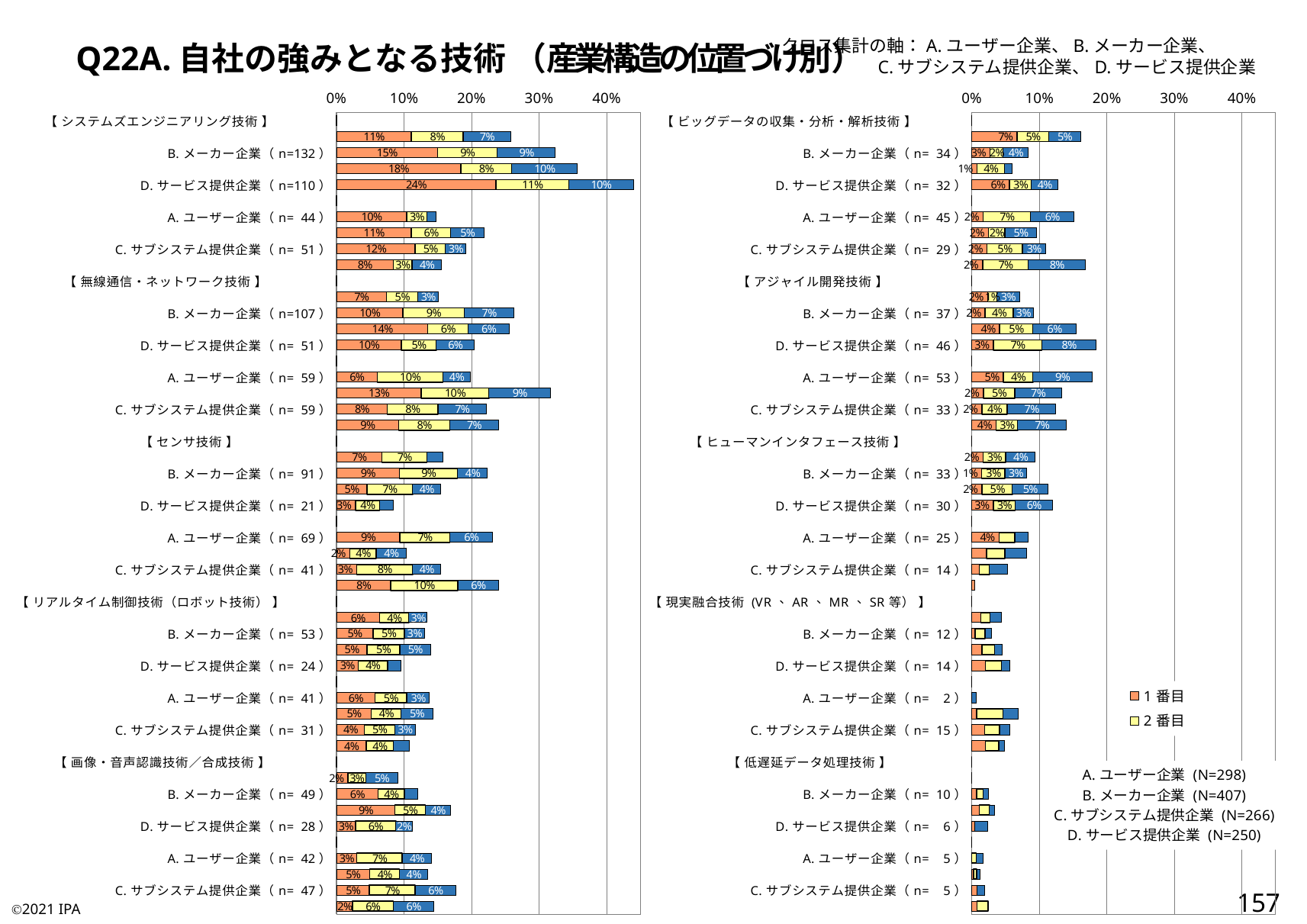
In the right chart, what is the total of the stacked bar for D. サービス提供企業 (n=46) under アジャイル開発技術? 18% In the left chart, what is the 1番目 value for D. サービス提供企業 (n=110) under システムズエンジニアリング技術? 24% In the left chart, is the total bar for D. サービス提供企業 (n=110) under システムズエンジニアリング技術 greater or less than 40%? greater In the left chart, what is the difference between the 1番目 values of D. サービス提供企業 (n=110) and B. メーカー企業 (n=132) under システムズエンジニアリング技術? 9% In the right chart, is the bar for A. ユーザー企業 (n=2) under 現実融合技術 greater or less than 10%? less In the left chart, what is the total of the stacked bar for B. メーカー企業 (n=132) under システムズエンジニアリング技術? 33% In the right chart, what is the 1番目 value for B. メーカー企業 (n=34) under ビッグデータの収集・分析・解析技術? 3% In the left chart, what is the 2番目 value for B. メーカー企業 (n=132) under システムズエンジニアリング技術? 9% In the left chart, what is the total of the stacked bar for D. サービス提供企業 (n=110) under システムズエンジニアリング技術? 45% What kind of chart is shown on the left side of the slide? bar chart In the left chart, which has the larger 1番目 value under システムズエンジニアリング技術: B. メーカー企業 (n=132) or D. サービス提供企業 (n=110)? D. サービス提供企業 (n=110) How many series does the legend on the right chart list? 2